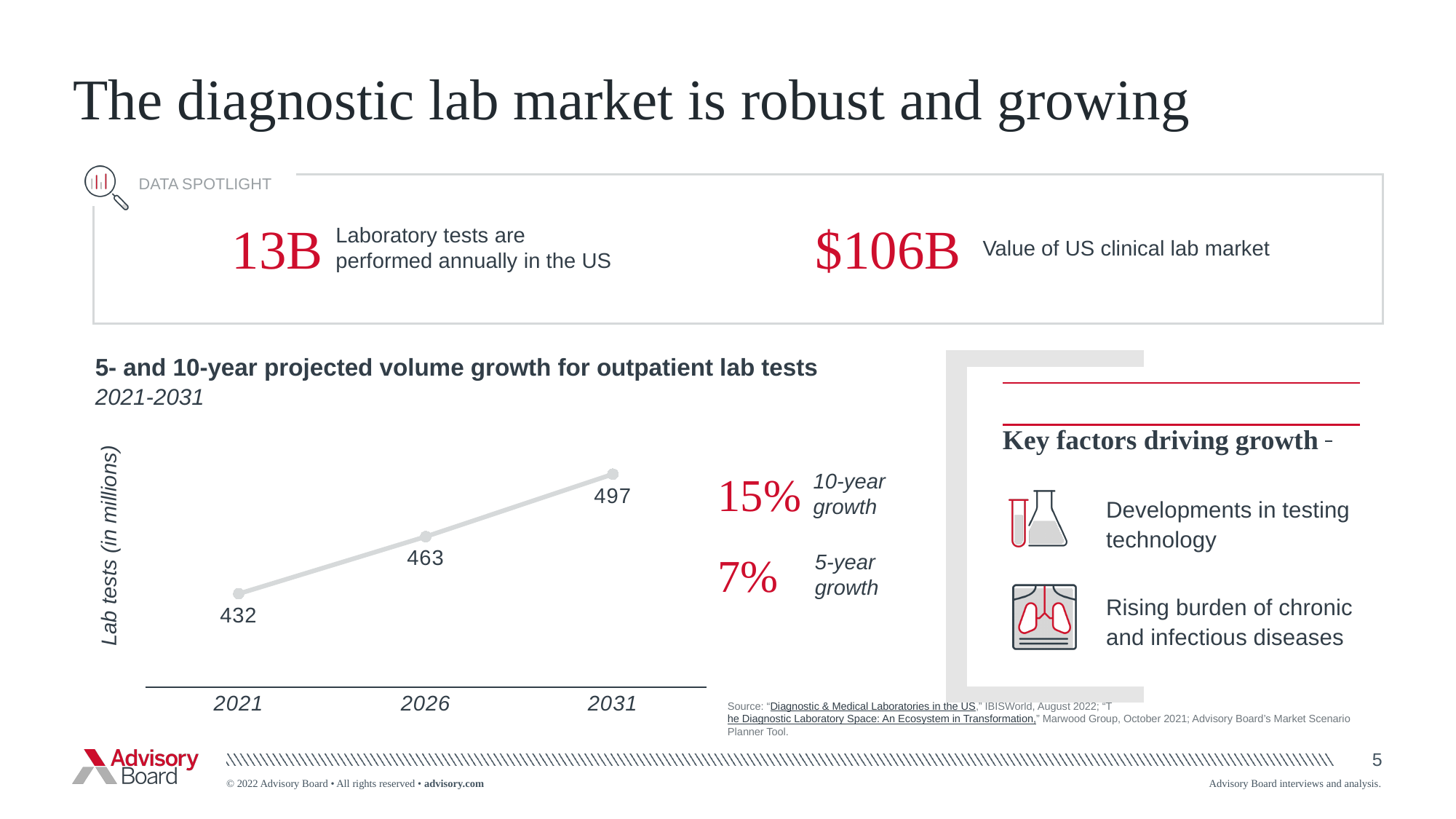
Which year has the lowest value in the projected volume growth chart? 2021 What is the difference between the 2031 and 2021 values in the projected volume growth chart? 65 Is the value for 2031 larger or smaller than the value for 2026? larger What is the difference between the 2026 and 2021 values in the projected volume growth chart? 31 How many data points are plotted in the projected volume growth chart? 3 Do the values in the projected volume growth chart rise or fall from 2021 to 2031? rise What kind of chart is used to show the projected volume growth for outpatient lab tests? line chart What is the value for 2021 in the projected volume growth chart? 432 What is the value for 2031 in the projected volume growth chart? 497 Which year has the highest value in the projected volume growth chart? 2031 What is the value for 2026 in the projected volume growth chart? 463 What is the y-axis label of the projected volume growth chart? Lab tests (in millions)